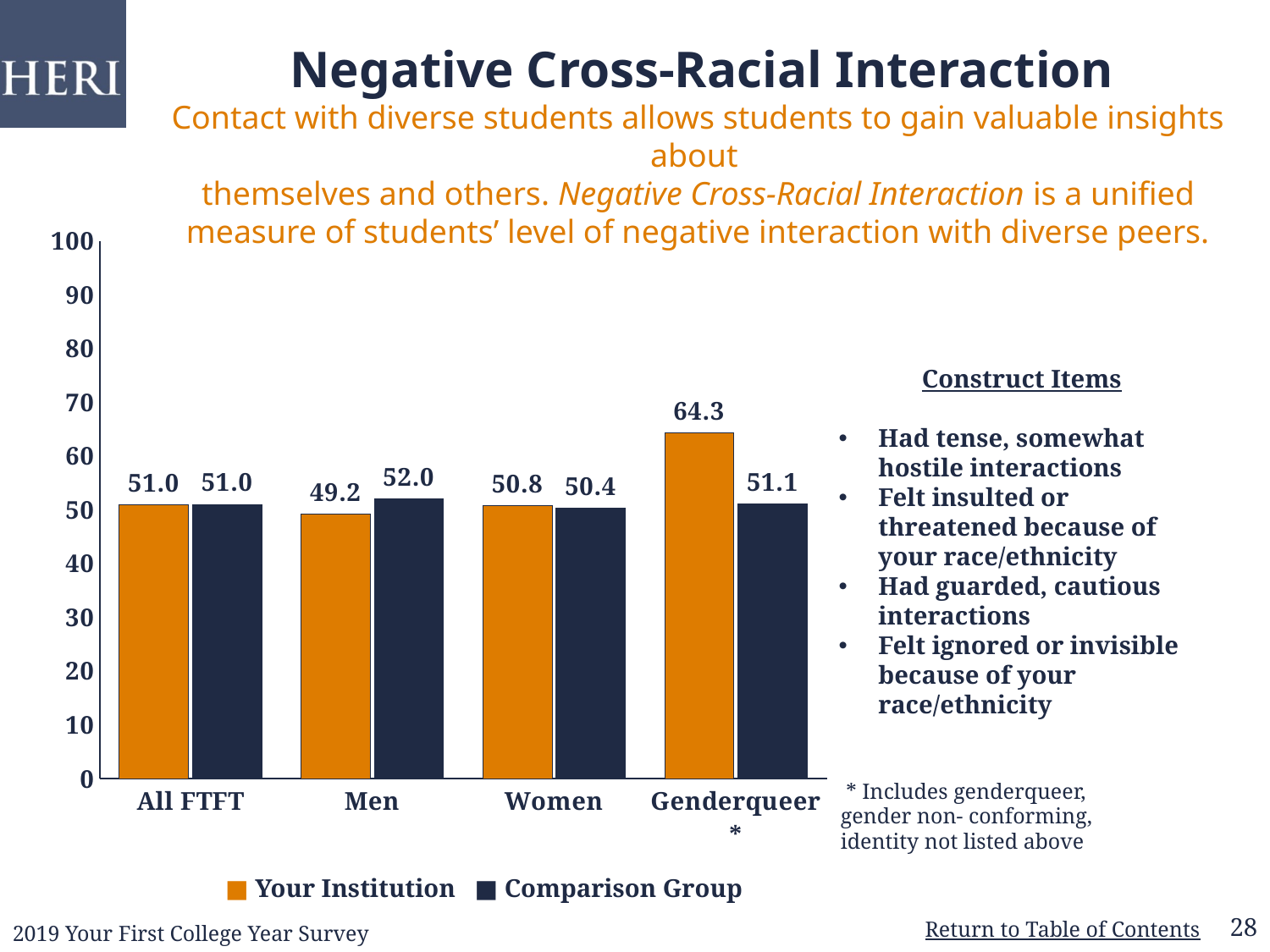
Which category has the highest Your Institution value? Genderqueer What is the difference between the Your Institution and Comparison Group values for Genderqueer? 13.2 Is the Your Institution value for Genderqueer greater or less than 60? greater What is the Comparison Group value for Men? 52.0 What is the Your Institution value for Genderqueer? 64.3 What is the difference between the Comparison Group values for Men and Women? 1.6 What kind of chart is shown on the slide? Bar chart What is the Your Institution value for Women? 50.8 Which category has the lowest Your Institution value? Men How many categories are shown on the x axis? 4 How many series does the legend list? 2 For Men, which is larger: Your Institution or Comparison Group? Comparison Group